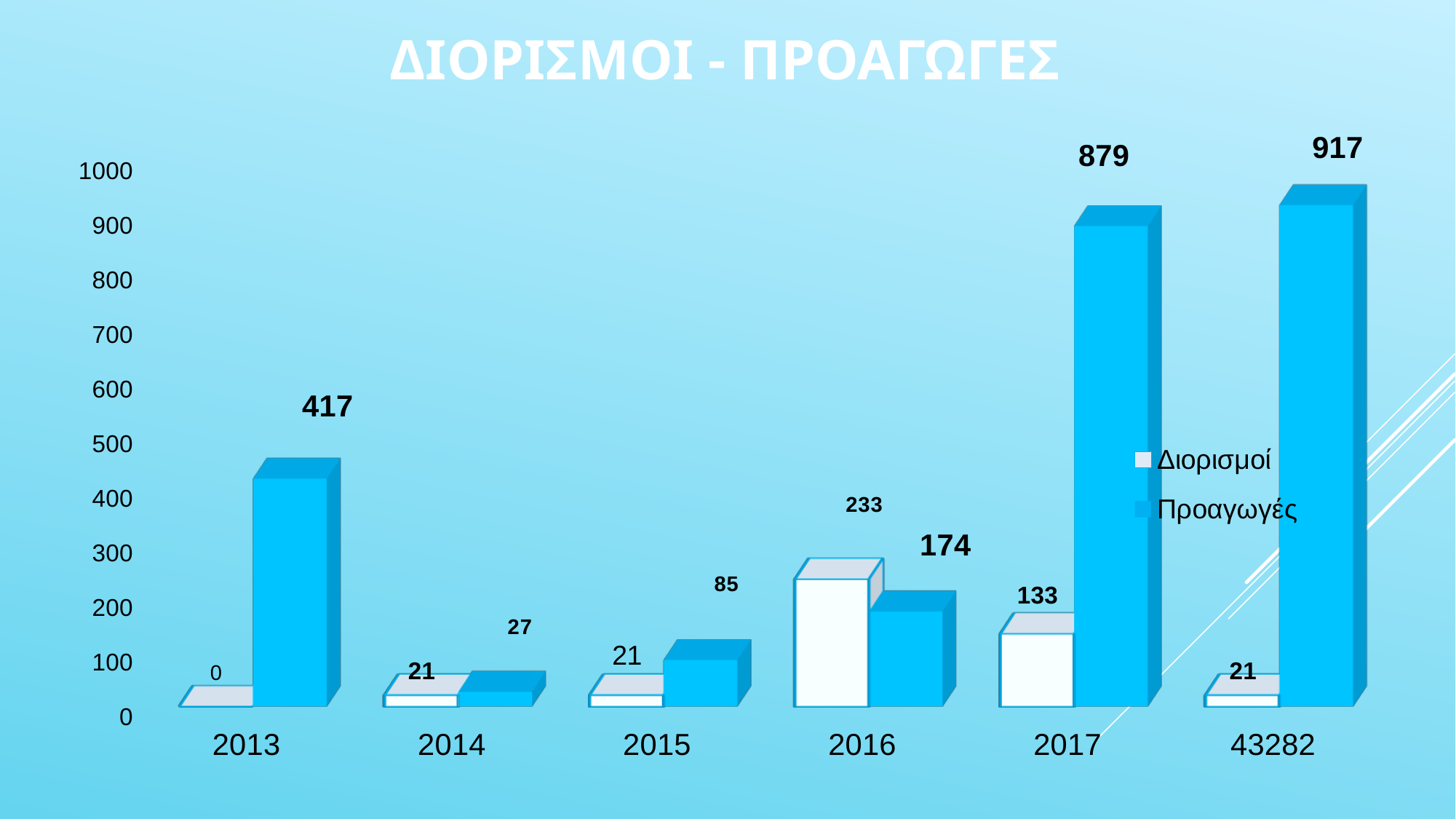
What is the value of Προαγωγές for 2013? 417 What is the value of Προαγωγές for 2017? 879 How many categories are shown on the x axis? 6 What is the difference between Προαγωγές for 43282 and Προαγωγές for 2017? 38 What type of chart is shown on the slide? bar chart What is the difference between Διορισμοί and Προαγωγές for 2015? 64 What is the value of Διορισμοί for 2016? 233 How many series does the legend list? 2 What is the title of the chart? ΔΙΟΡΙΣΜΟΙ - ΠΡΟΑΓΩΓΕΣ Which category has the lowest value for Διορισμοί? 2013 Which is larger for 2016: Διορισμοί or Προαγωγές? Διορισμοί Which category has the highest value for Προαγωγές? 43282